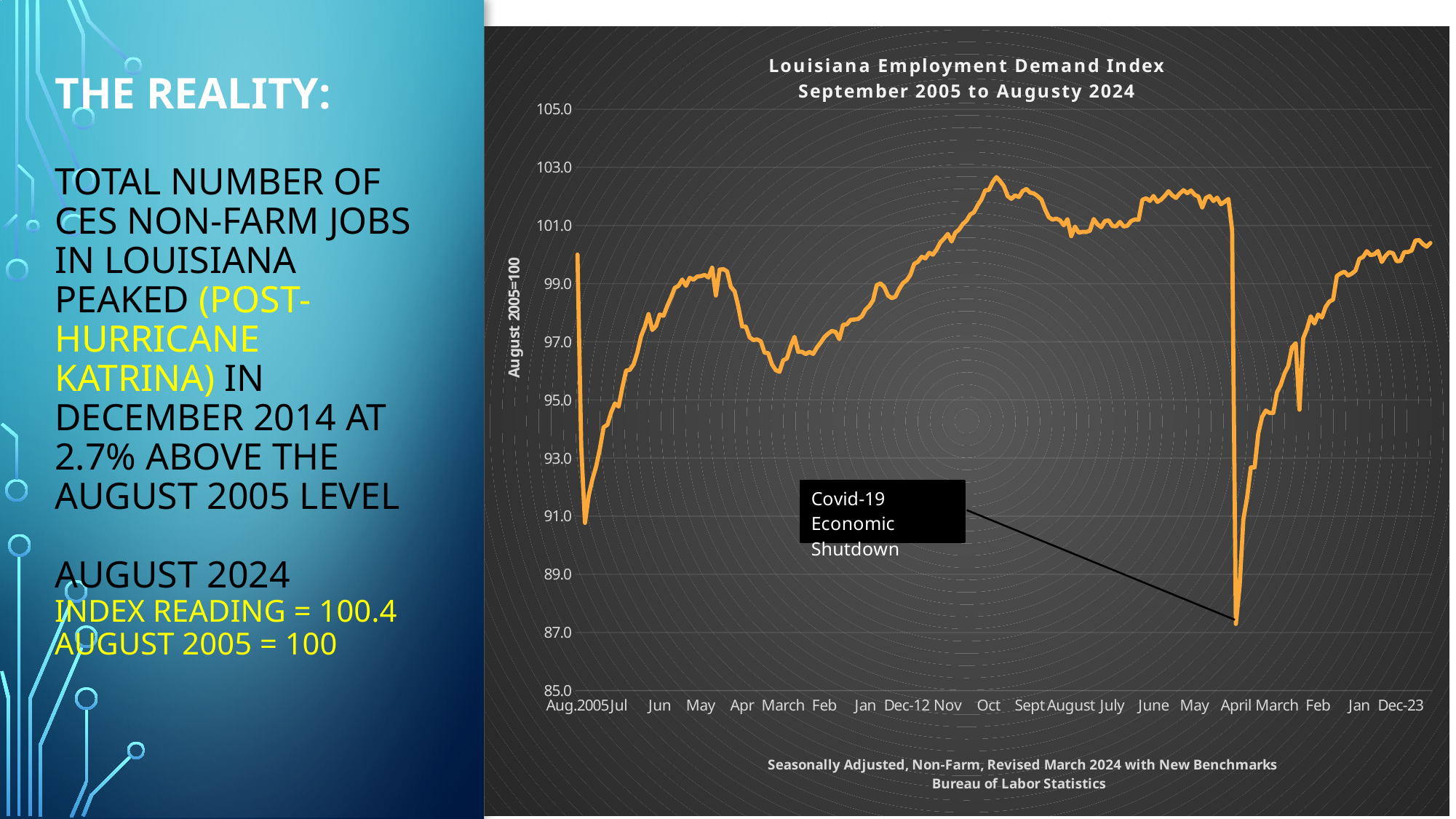
Is the highest value on the chart greater or less than 103.0? less Which event is marked by the annotation at the lowest point of the chart? Covid-19 Economic Shutdown Is the lowest value reached right after Aug.2005 greater or less than 93.0? less What kind of chart is shown on the slide? line chart Is the value at the point labelled 'Covid-19 Economic Shutdown' greater or less than 89.0? less What is the title of the chart? Louisiana Employment Demand Index September 2005 to Augusty 2024 What is the label on the vertical axis of the chart? August 2005=100 How many data series are plotted on the chart? 1 Does the index rise or fall from the Covid-19 Economic Shutdown low to the end of the series? rise According to the slide, what is the index reading for August 2024? 100.4